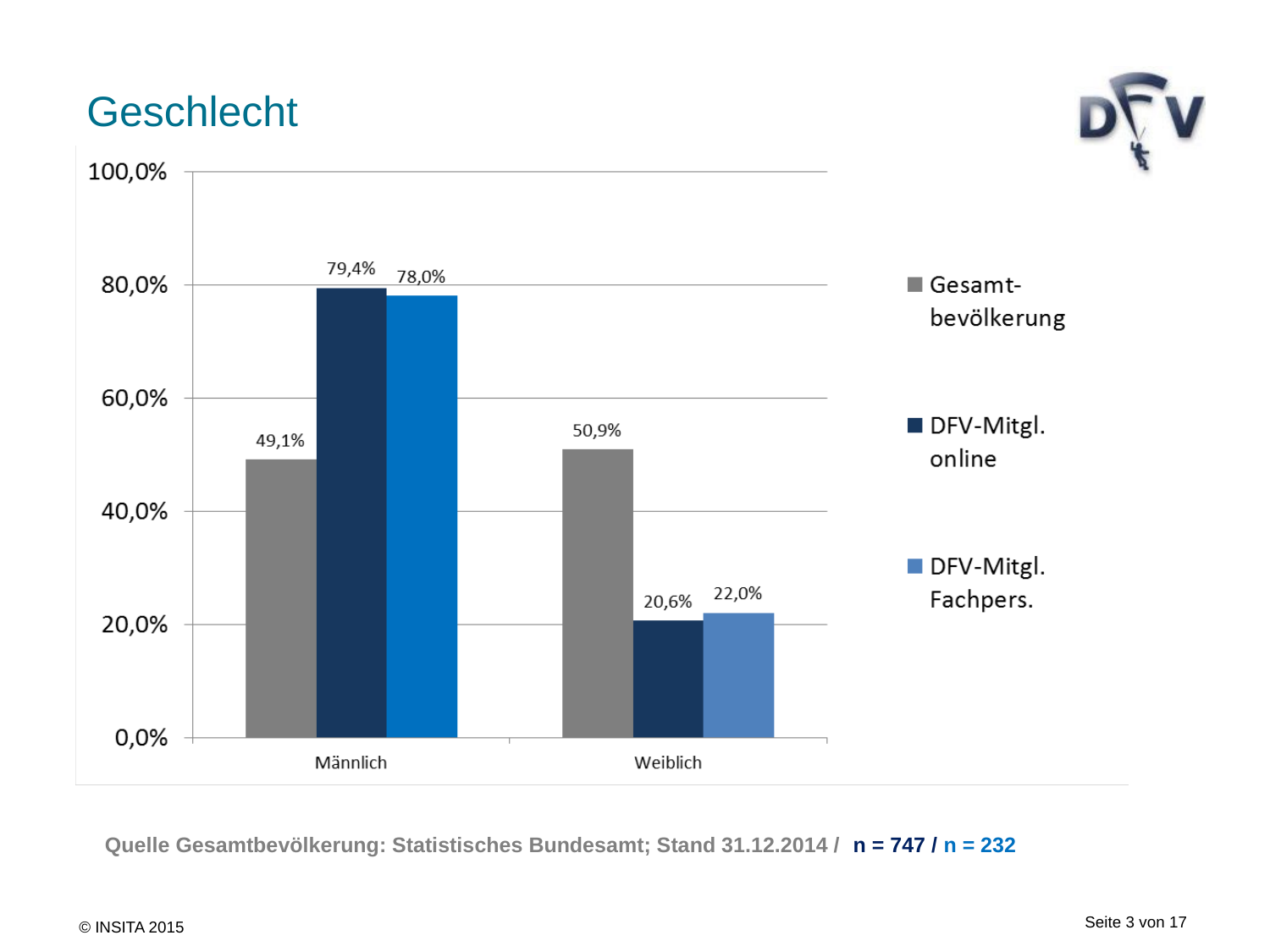
How many categories are shown on the x axis? 2 What is the value for Gesamtbevölkerung in the Männlich category? 49,1% Which series has the lowest value in the Weiblich category? DFV-Mitgl. online What is the difference between the DFV-Mitgl. online values for Männlich and Weiblich? 58,8% What is the value for DFV-Mitgl. online in the Weiblich category? 20,6% What kind of chart is shown on the slide? Bar chart Which is larger: the DFV-Mitgl. Fachpers. value for Weiblich or the DFV-Mitgl. online value for Weiblich? DFV-Mitgl. Fachpers. What is the difference between the Gesamtbevölkerung values for Weiblich and Männlich? 1,8% Is the value for DFV-Mitgl. online in the Männlich category greater or less than 60,0%? greater What is the value for DFV-Mitgl. Fachpers. in the Männlich category? 78,0% How many series does the legend list? 3 Which series has the highest value in the Männlich category? DFV-Mitgl. online